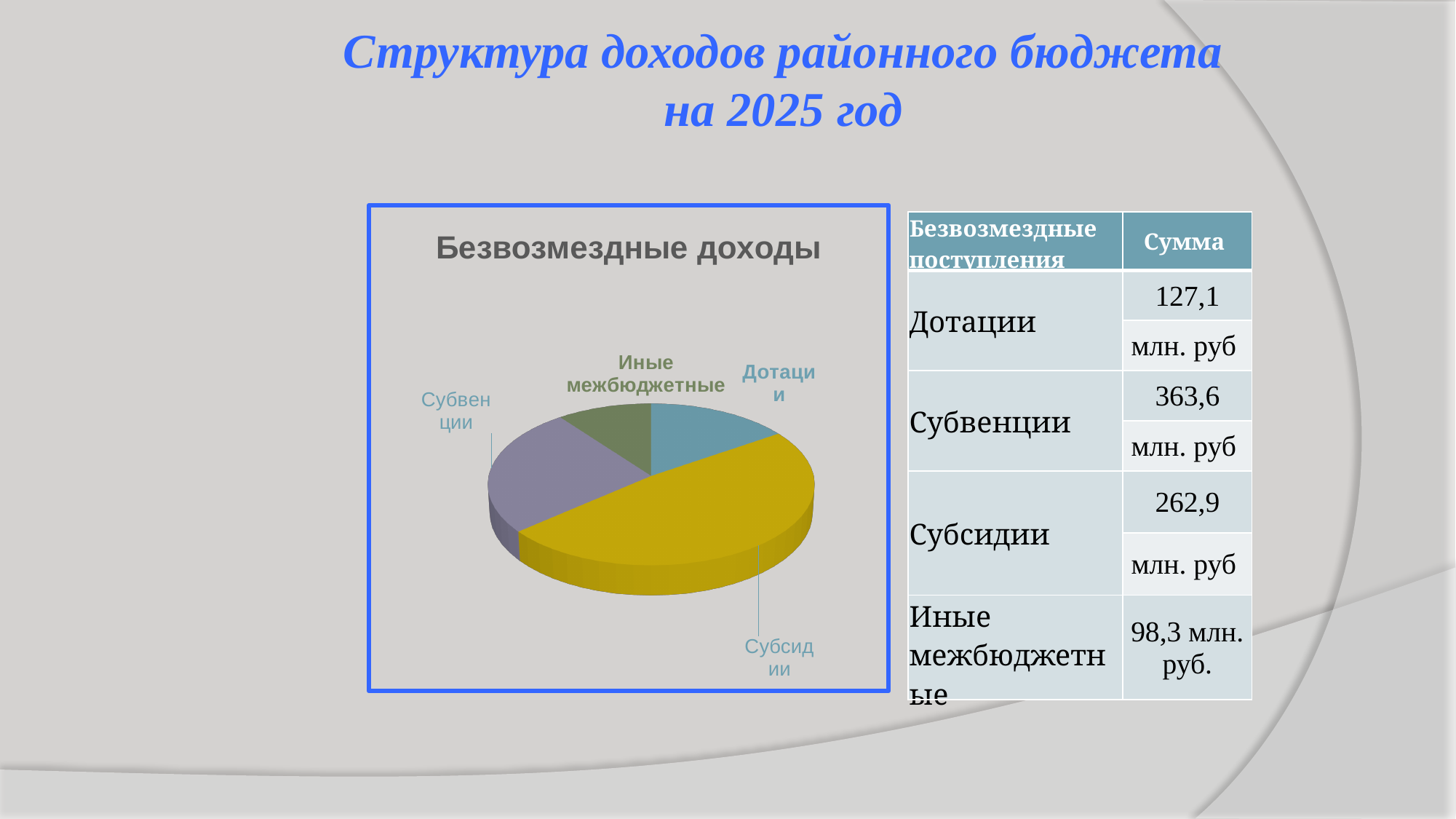
In the pie chart, which slice is larger: Дотации or Иные межбюджетные? Дотации How many slices does the pie chart have? 4 Which slice of the pie chart is the largest? Субсидии In the pie chart, which slice is larger: Субсидии or Субвенции? Субсидии In the pie chart, which slice is larger: Субвенции or Дотации? Субвенции What is the title of the pie chart? Безвозмездные доходы What kind of chart is shown on the slide? pie chart What colour is the Субсидии slice in the pie chart? yellow Which slice of the pie chart is the smallest? Иные межбюджетные